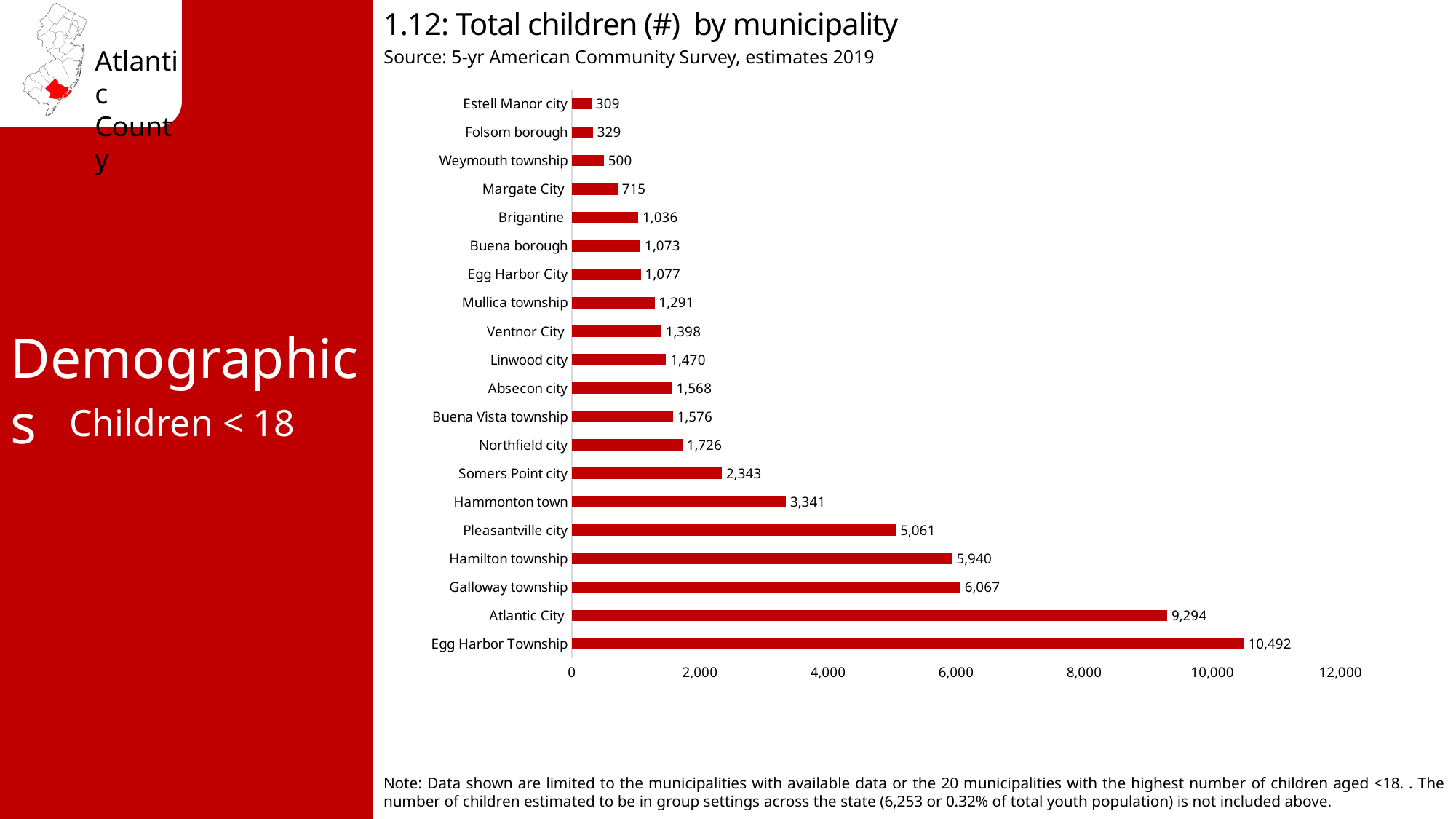
What kind of chart is shown on the slide? bar chart What is the total number of children in Weymouth township? 500 Which municipality has the highest number of children? Egg Harbor Township How many municipalities are shown in the chart? 20 What is the source of the data shown in the chart? 5-yr American Community Survey, estimates 2019 Which has more children, Pleasantville city or Hamilton township? Hamilton township What is the total number of children in Egg Harbor Township? 10,492 What is the difference in the number of children between Folsom borough and Estell Manor city? 20 Which municipality has the lowest number of children? Estell Manor city What is the total number of children in Hammonton town? 3,341 Is the value for Somers Point city greater or less than 2,000? greater What is the difference in the number of children between Atlantic City and Galloway township? 3,227